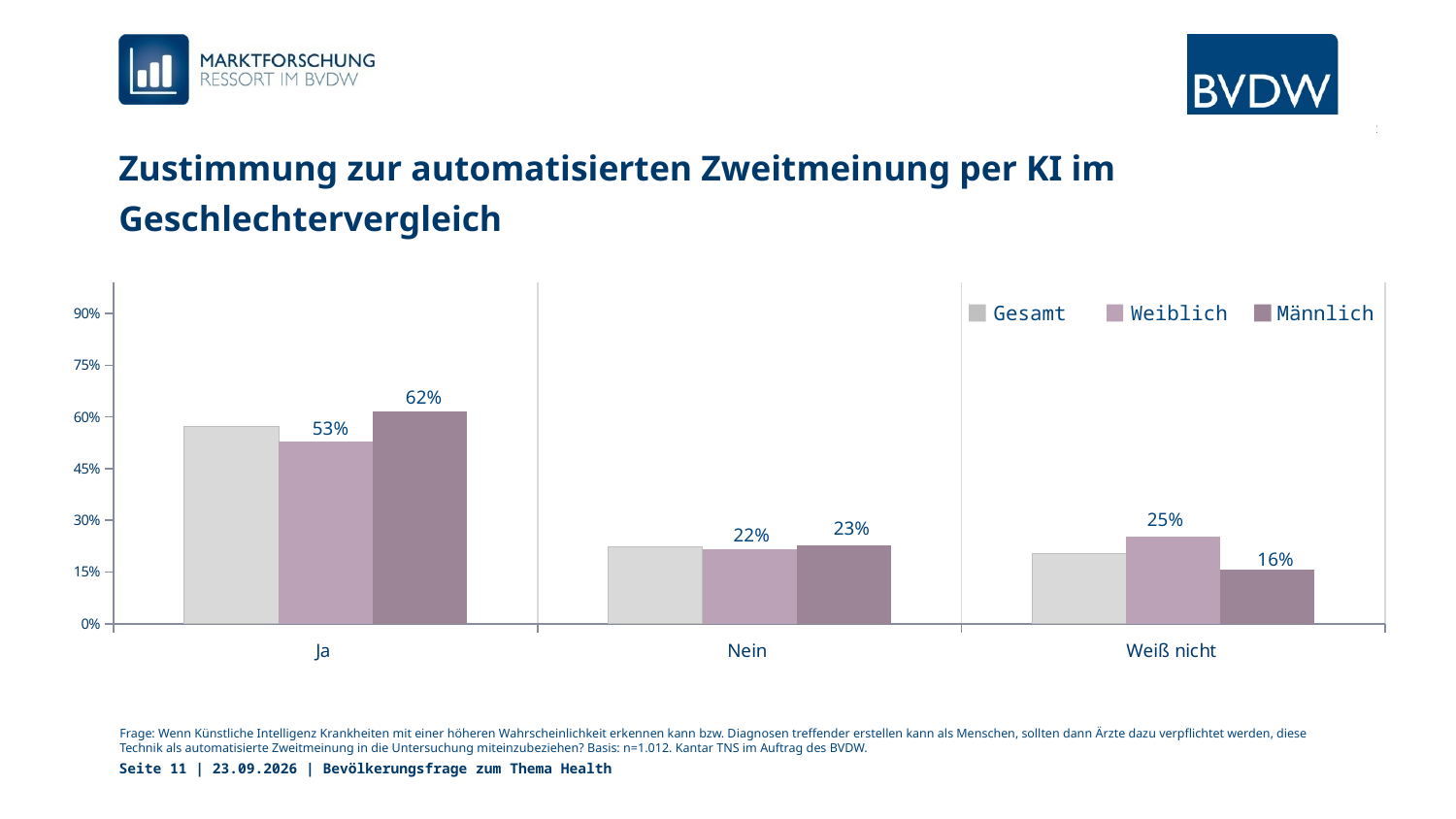
Which is larger in the category Weiß nicht: the Weiblich value or the Männlich value? Weiblich What kind of chart is shown on the slide? bar chart What is the value for Männlich in the category Ja? 62% How many categories are shown on the x axis? 3 What is the difference between the Männlich and Weiblich values in the category Ja? 9% How many series does the legend list? 3 What is the value for Männlich in the category Nein? 23% Which series is shown in the lightest grey colour in the legend? Gesamt What is the value for Weiblich in the category Ja? 53% Is the value for Gesamt in the category Ja greater or less than 45%? greater In which category is the Männlich value lowest? Weiß nicht What is the value for Weiblich in the category Weiß nicht? 25%